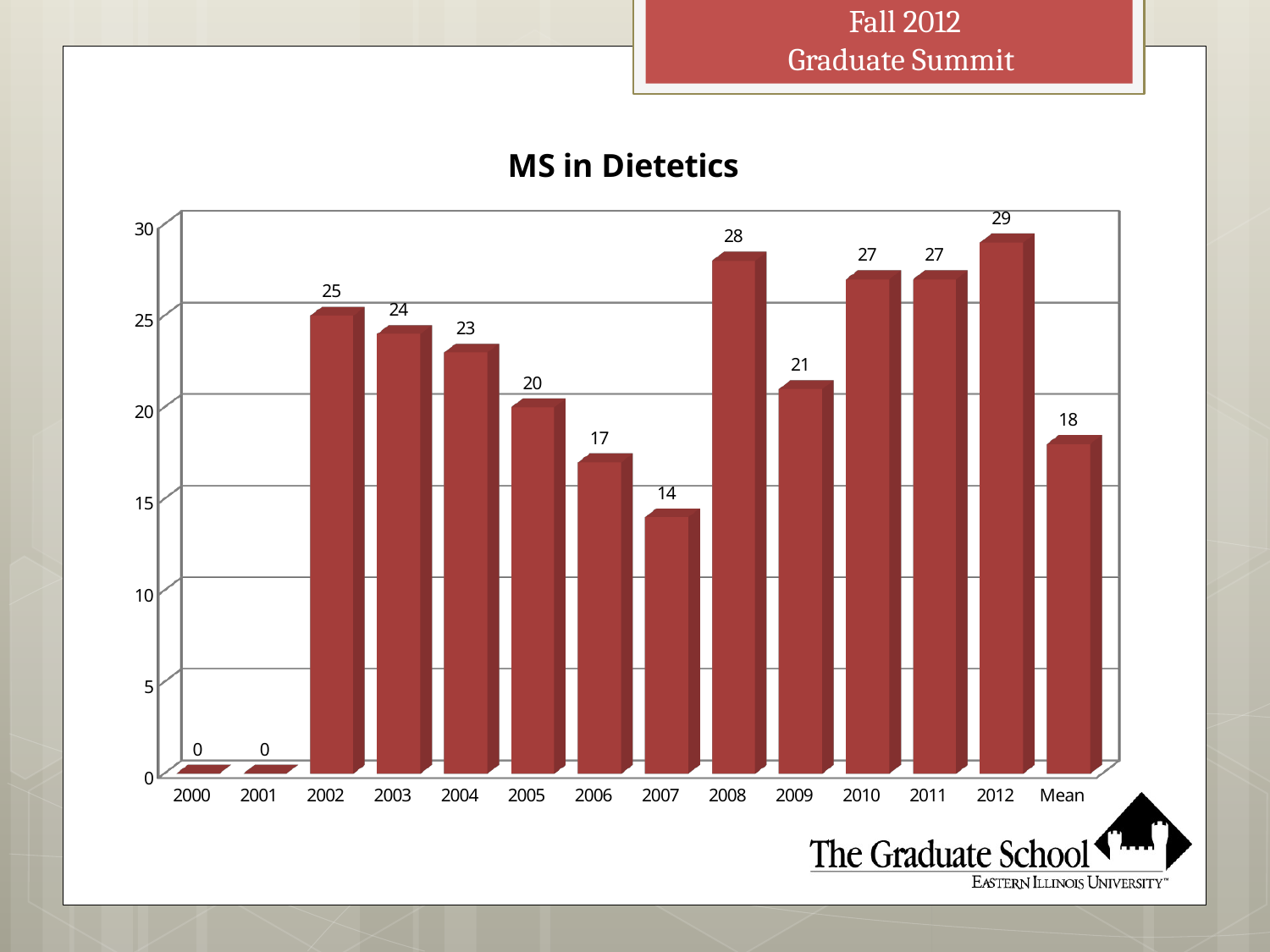
What is the difference between the values for 2012 and 2007? 15 How many categories are shown on the x axis? 14 What kind of chart is this? bar chart What is the value shown for Mean? 18 What is the value for 2000? 0 Do the values rise or fall from 2002 to 2007? fall What is the value for 2008? 28 Among the years from 2002 to 2012, which has the lowest value? 2007 Which is larger, the value for 2005 or the value for 2009? 2009 Which year has the highest value? 2012 What is the title of the chart? MS in Dietetics What is the value for 2007? 14